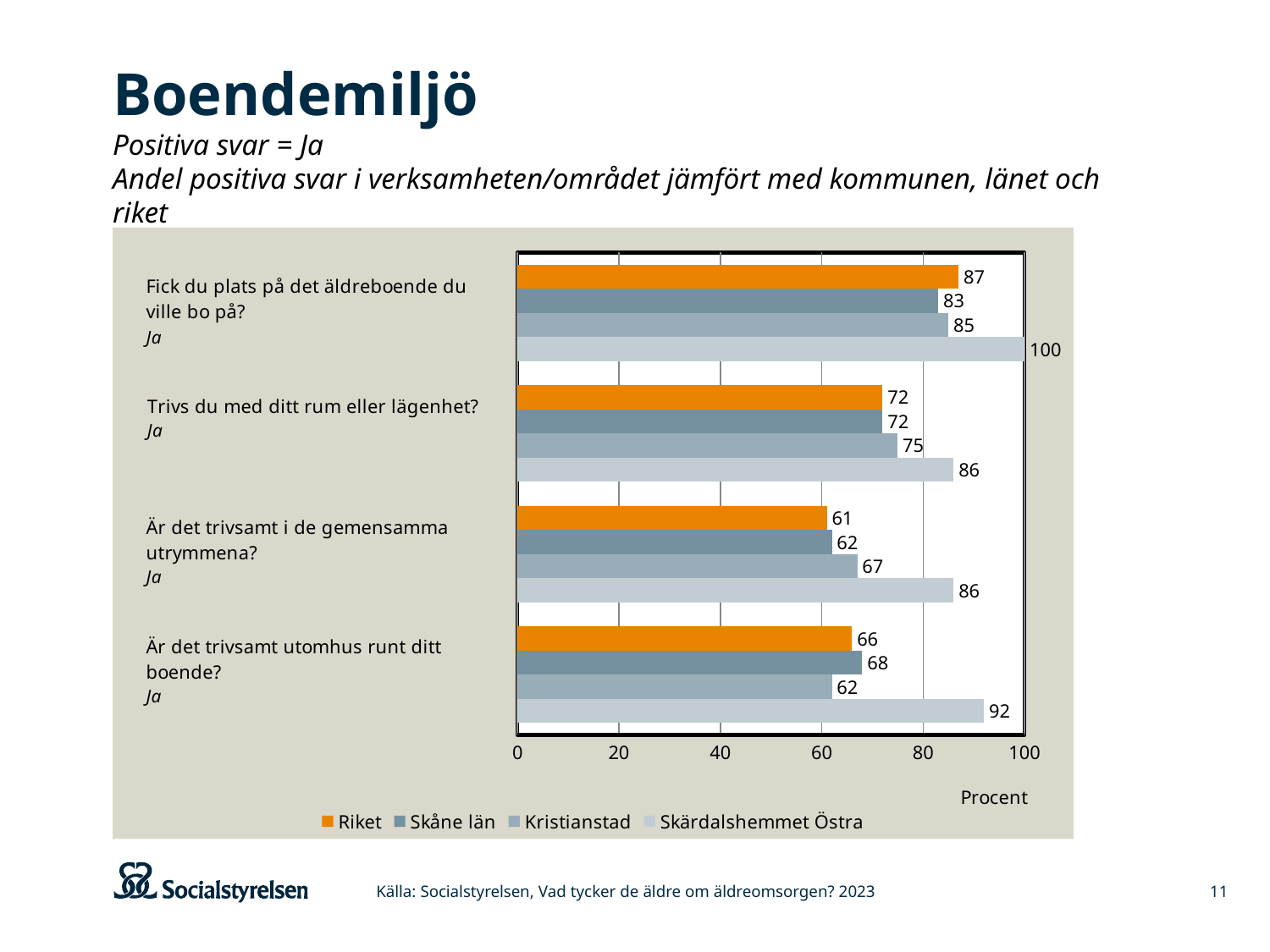
Which series has the lowest value for 'Är det trivsamt i de gemensamma utrymmena?' Riket For 'Är det trivsamt utomhus runt ditt boende?', which is larger: the value for Skåne län or the value for Kristianstad? Skåne län How many question categories are plotted in the chart? 4 How many series does the legend list? 4 What is the value for Riket for 'Trivs du med ditt rum eller lägenhet?' 72 What label is shown on the horizontal axis of the chart? Procent What is the value for Skärdalshemmet Östra for 'Fick du plats på det äldreboende du ville bo på?' 100 What is the value for Kristianstad for 'Är det trivsamt i de gemensamma utrymmena?' 67 Which series has the highest value for 'Är det trivsamt utomhus runt ditt boende?' Skärdalshemmet Östra What is the difference between Skärdalshemmet Östra and Riket for 'Är det trivsamt i de gemensamma utrymmena?' 25 What kind of chart is shown on the slide? bar chart What is the value for Skåne län for 'Är det trivsamt utomhus runt ditt boende?' 68